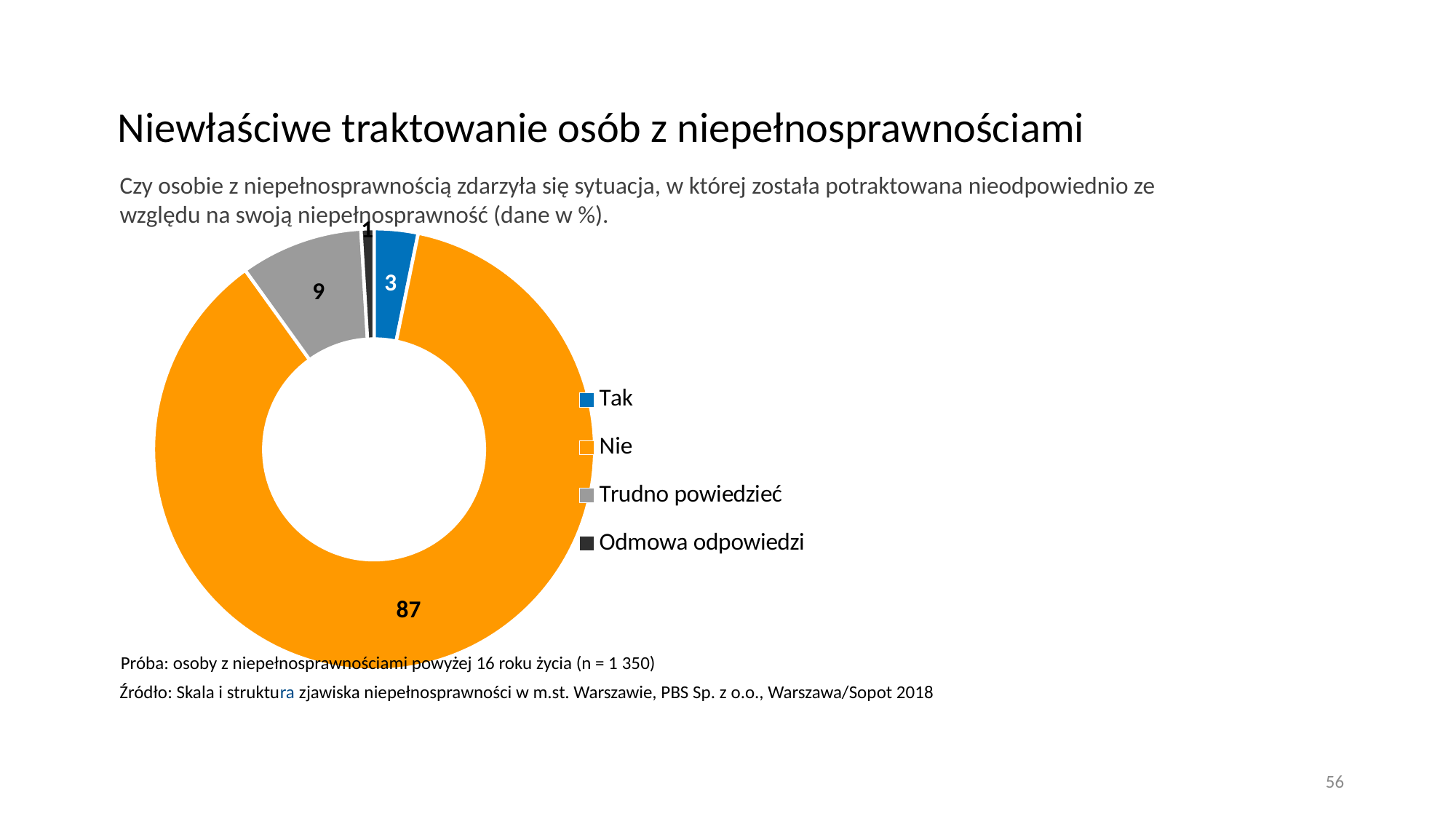
How many categories does the legend list? 4 What kind of chart is shown on the slide? Doughnut (pie) chart What value is shown for the "Trudno powiedzieć" slice? 9 What is the difference between the values for "Nie" and "Trudno powiedzieć"? 78 What is the sample size (n) stated below the chart? 1 350 What colour is the "Nie" slice? Orange What value is shown for the "Odmowa odpowiedzi" slice? 1 Which is larger, the value for "Trudno powiedzieć" or the value for "Tak"? Trudno powiedzieć Which category has the largest slice? Nie What value is shown for the "Tak" slice? 3 Which category has the smallest slice? Odmowa odpowiedzi What value is shown for the "Nie" slice? 87